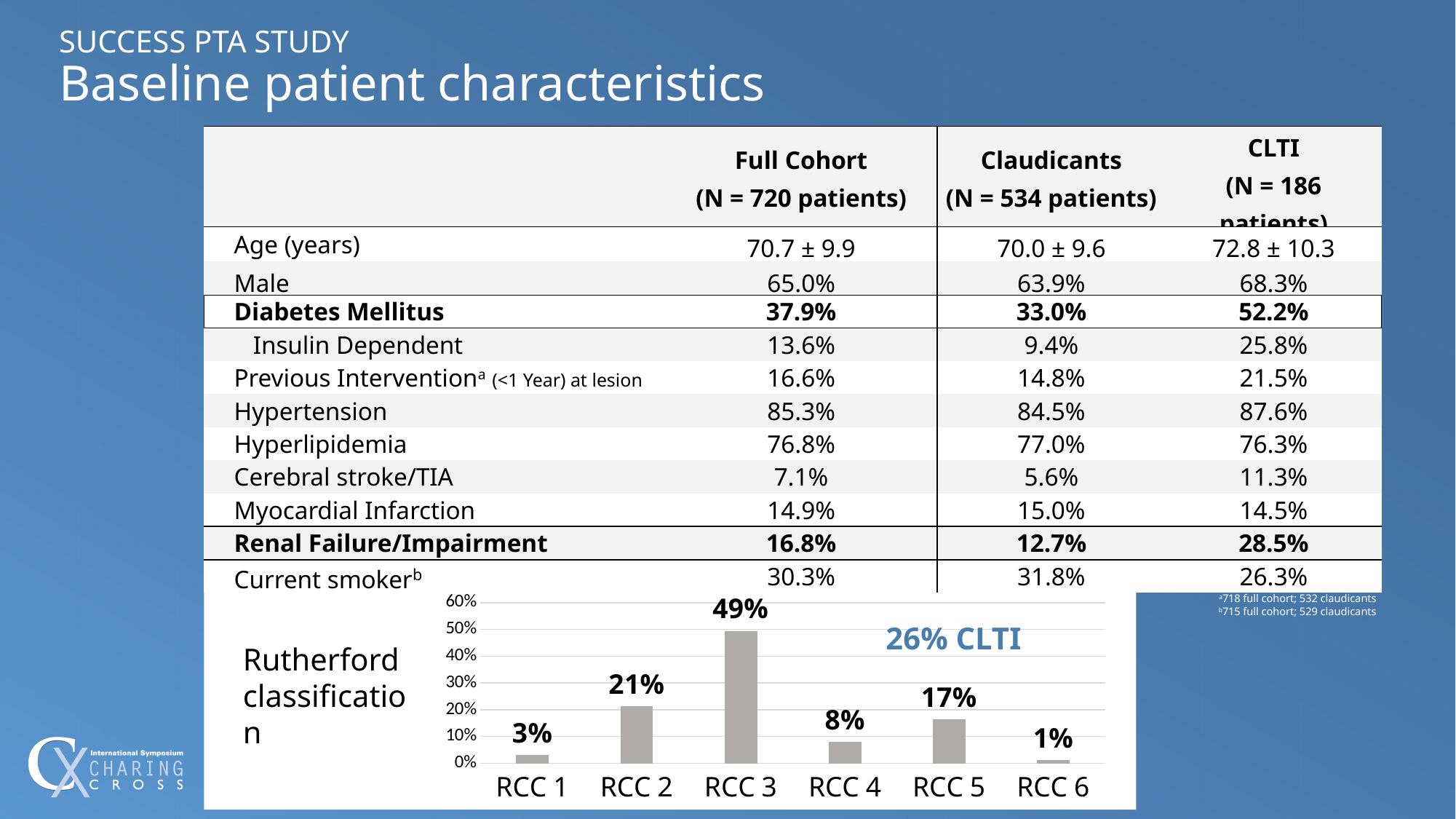
What is the value for RCC 5 in the Rutherford classification chart? 17% What is the value for RCC 1 in the Rutherford classification chart? 3% What kind of chart is the Rutherford classification chart? bar chart What is the value for RCC 2 in the Rutherford classification chart? 21% Is the value for RCC 3 in the Rutherford classification chart greater or less than 40%? greater How many Rutherford categories are shown in the chart? 6 What percentage is labelled as CLTI in the Rutherford classification chart? 26% Which Rutherford category has the lowest value in the chart? RCC 6 What is the value for RCC 3 in the Rutherford classification chart? 49% What is the difference between the values for RCC 3 and RCC 2 in the Rutherford classification chart? 28% Which Rutherford category has the highest value in the chart? RCC 3 Which is larger in the Rutherford classification chart, RCC 4 or RCC 5? RCC 5